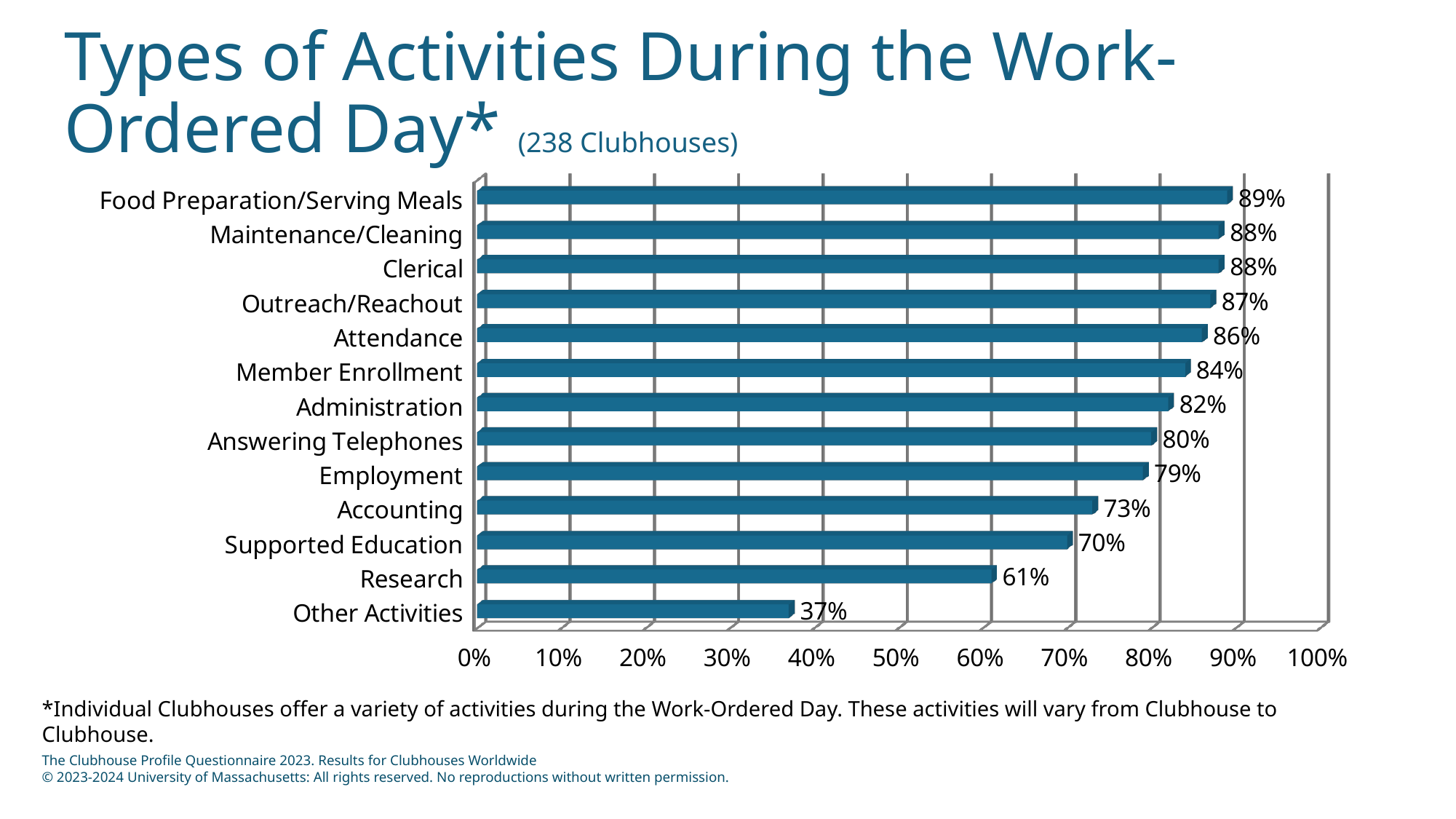
How many Clubhouses does the chart subtitle say the data covers? 238 Clubhouses What is the value shown for Research? 61% What is the difference between the values for Accounting and Other Activities? 36% What percentage of Clubhouses report Food Preparation/Serving Meals as an activity during the Work-Ordered Day? 89% What kind of chart is shown on the slide? Bar chart How many activity categories are shown in the chart? 13 Which activity has the lowest percentage? Other Activities Which is larger, the value for Administration or the value for Accounting? Administration What is the difference between the values for Attendance and Employment? 7% Is the value for Research greater or less than 50%? greater What is the value shown for Supported Education? 70% Which activity has the highest percentage? Food Preparation/Serving Meals